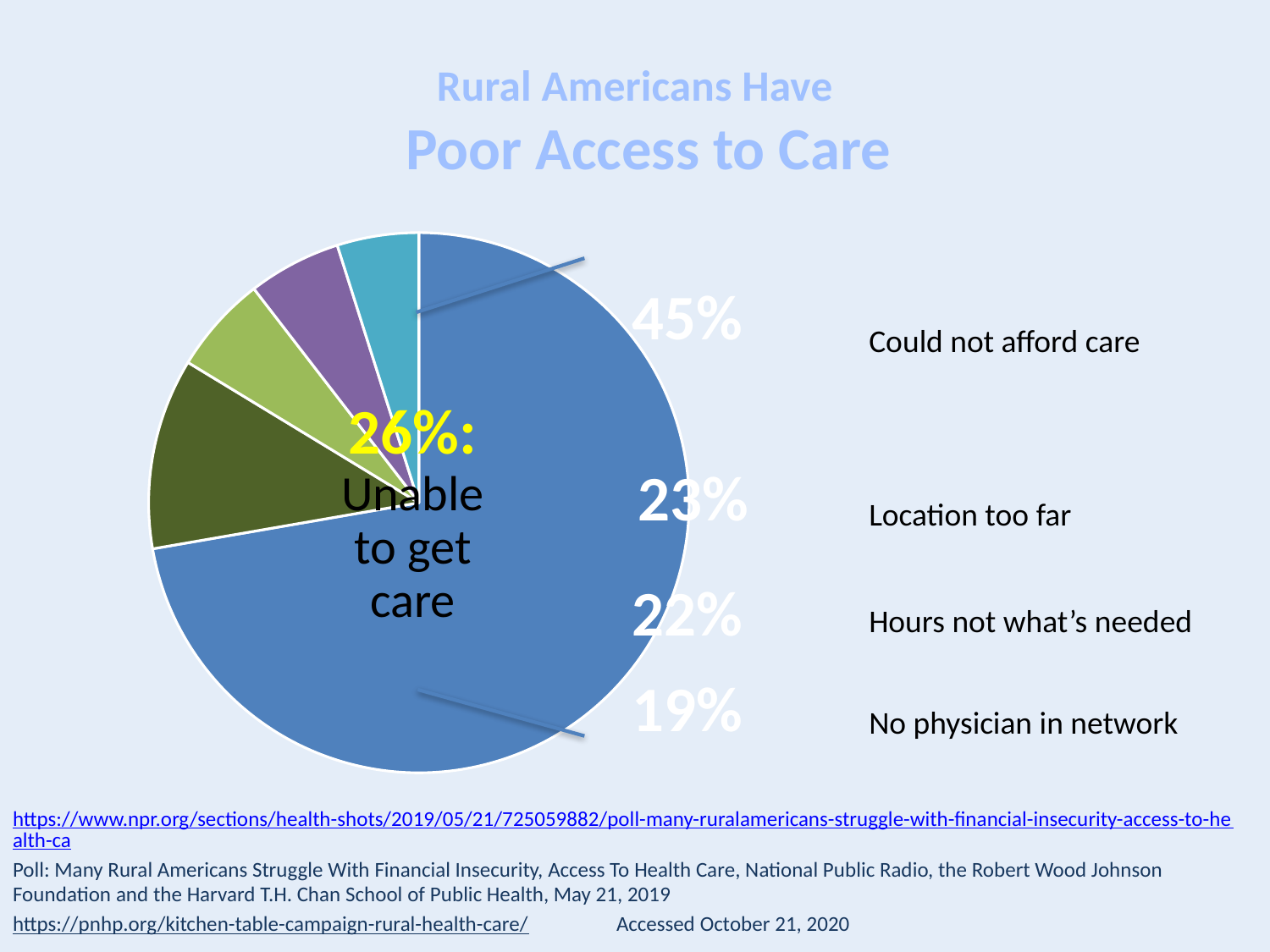
How many slices does the pie chart have? 5 What is the title of the slide containing the pie chart? Rural Americans Have Poor Access to Care What colour is the largest slice of the pie chart? Blue Which listed reason for being unable to get care has the highest percentage? Could not afford care What is the difference in percentage points between 'Could not afford care' and 'No physician in network'? 26 Which listed reason for being unable to get care has the lowest percentage? No physician in network What percentage is shown next to 'Hours not what's needed'? 22% What percentage is shown next to 'No physician in network'? 19% What percentage is shown next to 'Location too far'? 23% What percentage is shown next to 'Could not afford care'? 45% What kind of chart is shown on the slide? Pie chart What percentage of rural Americans does the pie chart label as unable to get care? 26%